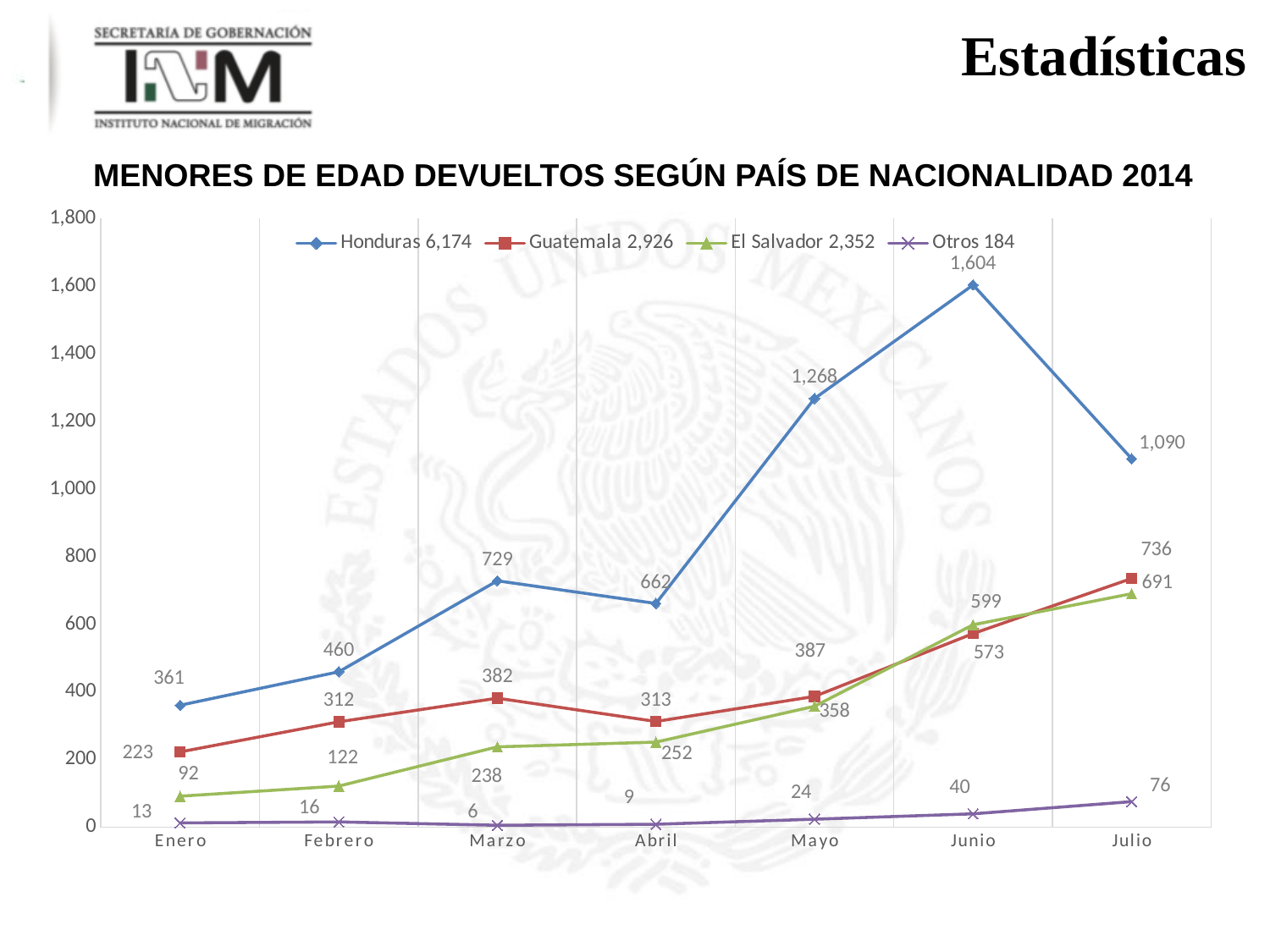
What is the value for Honduras in Junio? 1,604 What is the difference between the Honduras values in Junio and Julio? 514 How many series does the legend list? 4 What is the value for Guatemala in Julio? 736 Which is larger in Junio: the value for Guatemala or the value for El Salvador? El Salvador In which month does the Otros series have its lowest value? Marzo What is the value for Otros in Abril? 9 What is the value for El Salvador in Marzo? 238 What kind of chart is shown on the slide? Line chart What total is shown next to Honduras in the legend? 6,174 In which month does the Honduras series reach its highest value? Junio How many months are shown on the x axis? 7